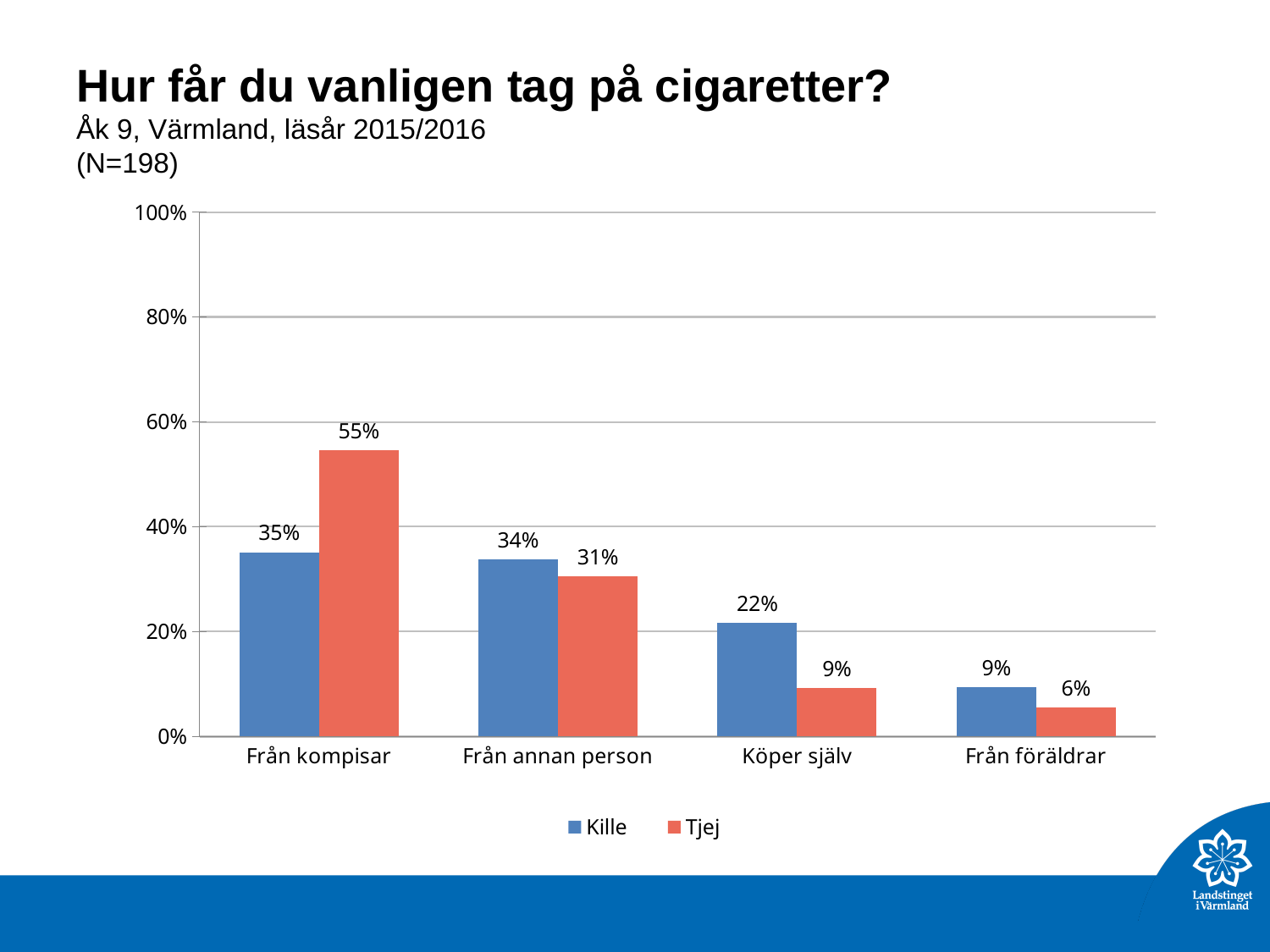
How many series does the legend list? 2 What is the value for Tjej in the Köper själv category? 9% How many categories are shown on the x axis? 4 What is the value for Kille in the Från föräldrar category? 9% Which category has the lowest value for Kille? Från föräldrar What is the value for Kille in the Från kompisar category? 35% What is the difference between the Tjej and Kille values in the Från kompisar category? 20% What is the value for Tjej in the Från kompisar category? 55% Which is larger in the Köper själv category, Kille or Tjej? Kille What kind of chart is shown on the slide? Bar chart Which category has the highest value for Tjej? Från kompisar What is the title of the chart on the slide? Hur får du vanligen tag på cigaretter?